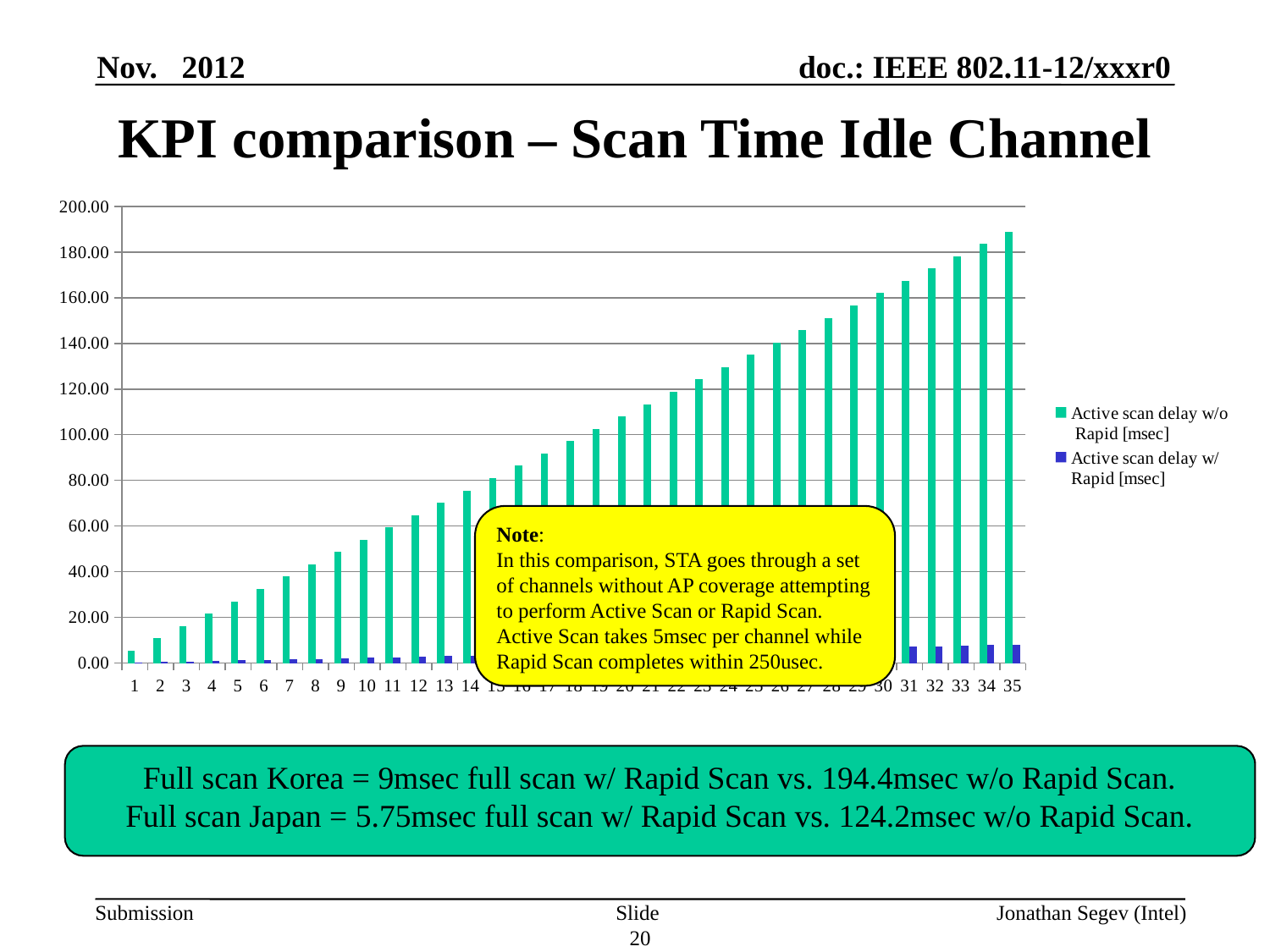
What kind of chart is shown on the slide? bar chart Do the values of the 'Active scan delay w/o Rapid [msec]' series rise or fall as the category number increases along the x axis? rise Is the 'Active scan delay w/o Rapid [msec]' value for category 30 greater or less than 140? greater Is the 'Active scan delay w/o Rapid [msec]' value for category 10 greater or less than 40? greater For category 35, which series has the larger value: 'Active scan delay w/o Rapid [msec]' or 'Active scan delay w/ Rapid [msec]'? Active scan delay w/o Rapid [msec] Is the 'Active scan delay w/o Rapid [msec]' value for category 35 greater or less than 180? greater How many series does the chart legend list? 2 Which category has the lowest value for the 'Active scan delay w/o Rapid [msec]' series? 1 Which category has the highest value for the 'Active scan delay w/o Rapid [msec]' series? 35 What are the two series names listed in the chart legend? Active scan delay w/o Rapid [msec]; Active scan delay w/ Rapid [msec] How many categories are shown along the x axis of the chart? 35